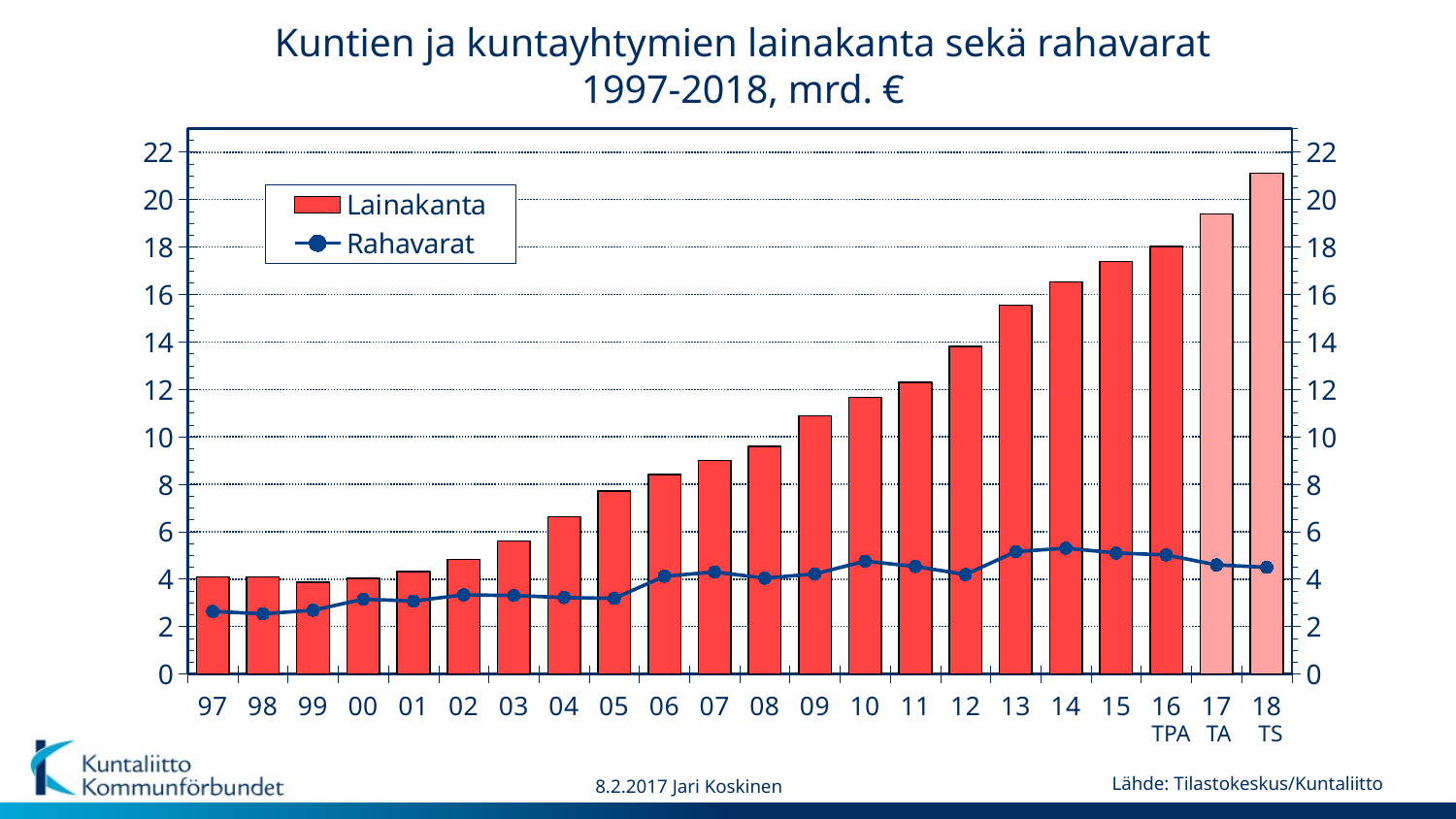
Is the Rahavarat value for 14 greater or less than 6? less In which year is the Lainakanta bar highest? 18 How many years are shown along the x axis? 22 How many series does the legend list? 2 Which year has the larger Lainakanta value, 08 or 09? 09 Which series is shown as a line with markers? Rahavarat Is the Lainakanta value for 18 greater or less than 20? greater Is the Lainakanta value for 10 greater or less than 12? less In 18, which is larger, Lainakanta or Rahavarat? Lainakanta Does the Lainakanta series generally rise or fall from 97 to 18? rise What kind of chart is shown on the slide? A bar chart combined with a line chart